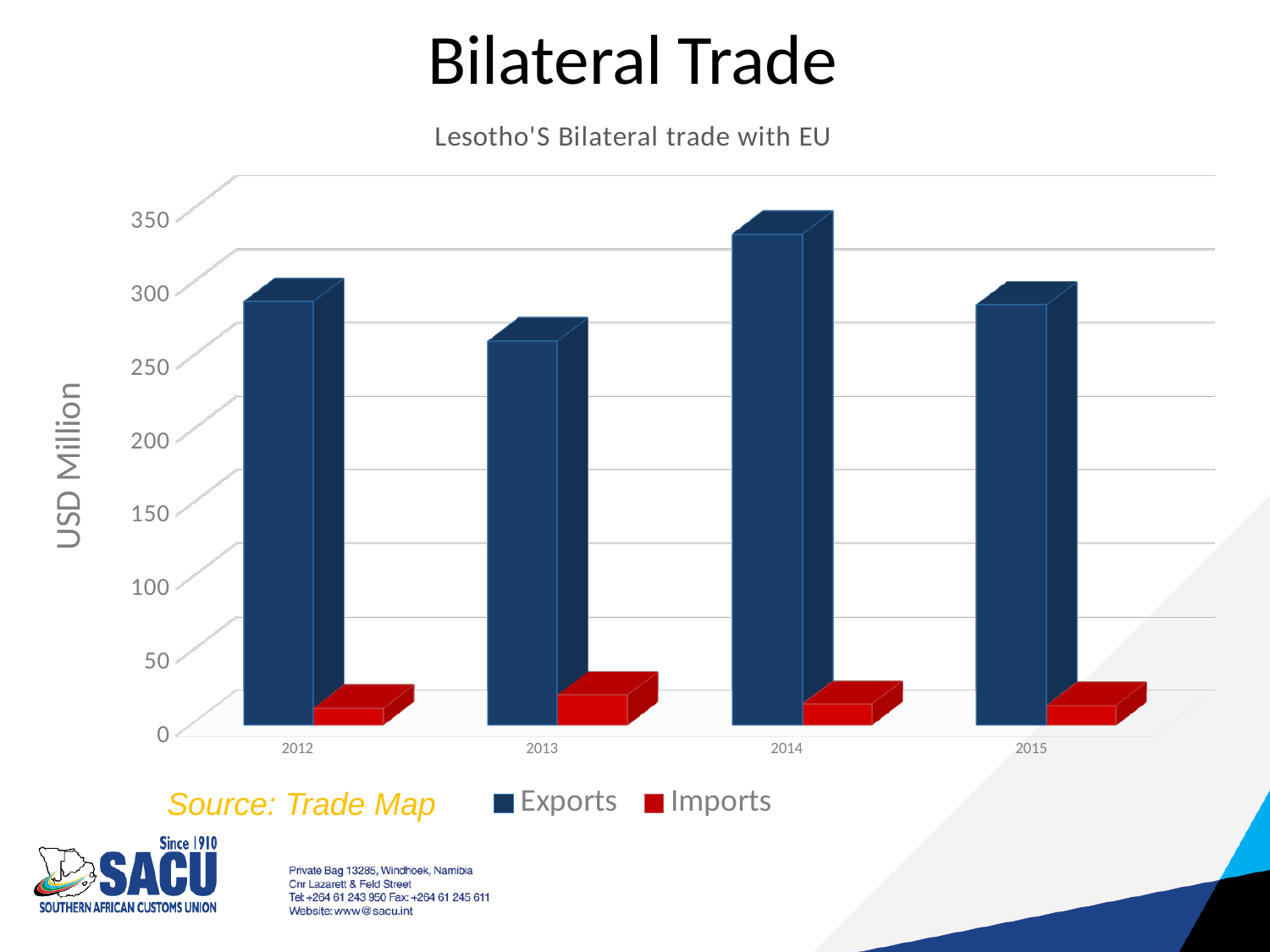
Which is larger, Exports in 2014 or Exports in 2013? Exports in 2014 What is the title of the chart? Lesotho'S Bilateral trade with EU In which year were Exports lowest? 2013 Which series is larger in 2015, Exports or Imports? Exports Is the value for Exports in 2014 greater or less than 300? greater How many years are shown on the x axis? 4 Is the value for Exports in 2013 greater or less than 300? less Is the value for Imports in 2012 greater or less than 50? less How many series does the legend list? 2 What kind of chart is shown on the slide? Bar chart In which year were Exports highest? 2014 What is the label on the vertical axis? USD Million